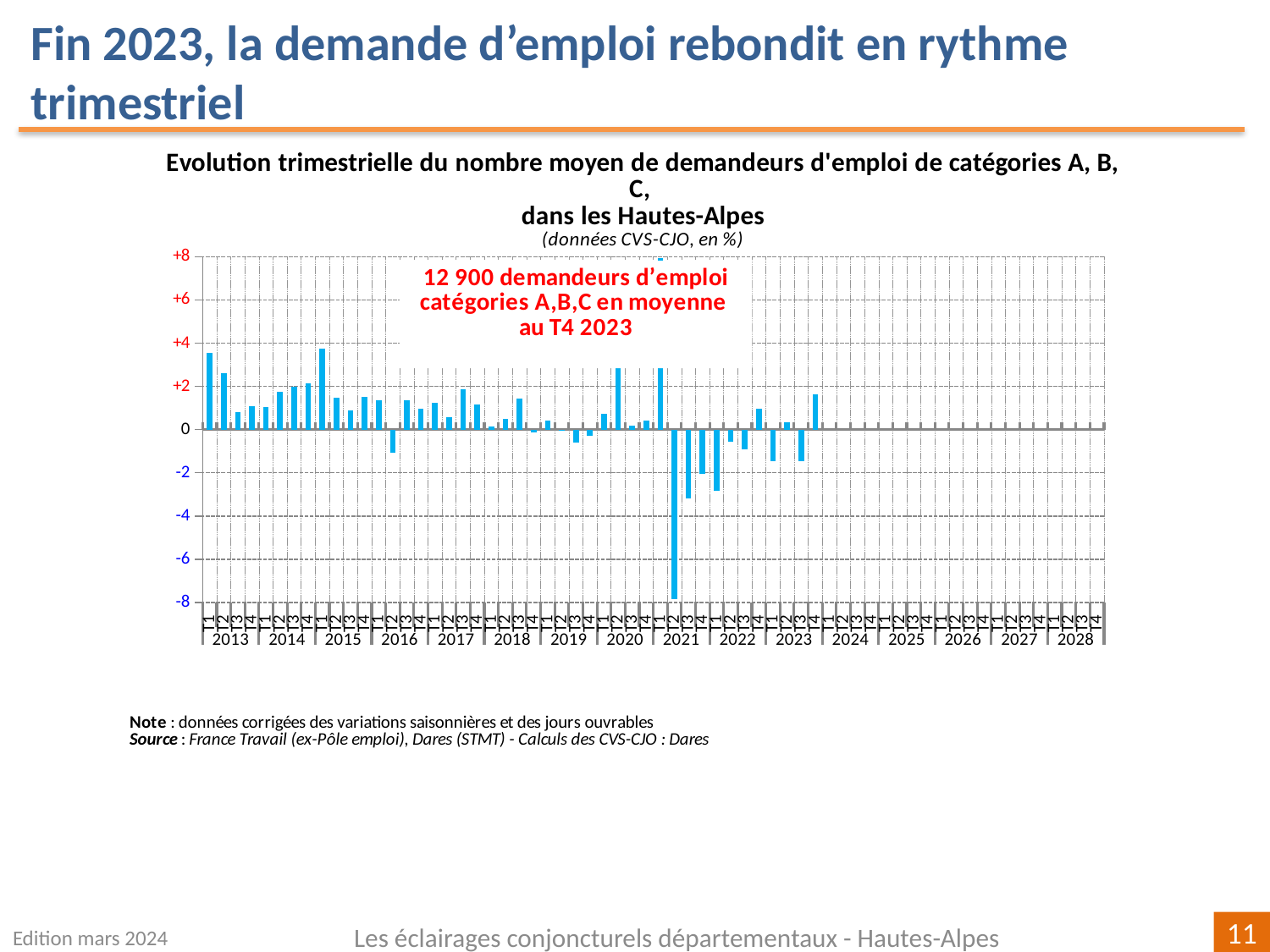
Which is lower, the value for T2 2021 or the value for T3 2021? T2 2021 How many years are labelled along the x axis of the chart? 16 Which quarter shows the lowest value in the chart? T2 2021 Which is higher, the value for T1 2013 or the value for T2 2013? T1 2013 Is the value for T3 2023 greater or less than 0? less Is the value for T2 2021 greater or less than -6? less Is the value for T4 2023 greater or less than 0? greater According to the annotation on the chart, how many demandeurs d'emploi catégories A,B,C were there on average in T4 2023? 12 900 What kind of chart is shown on the slide? bar chart